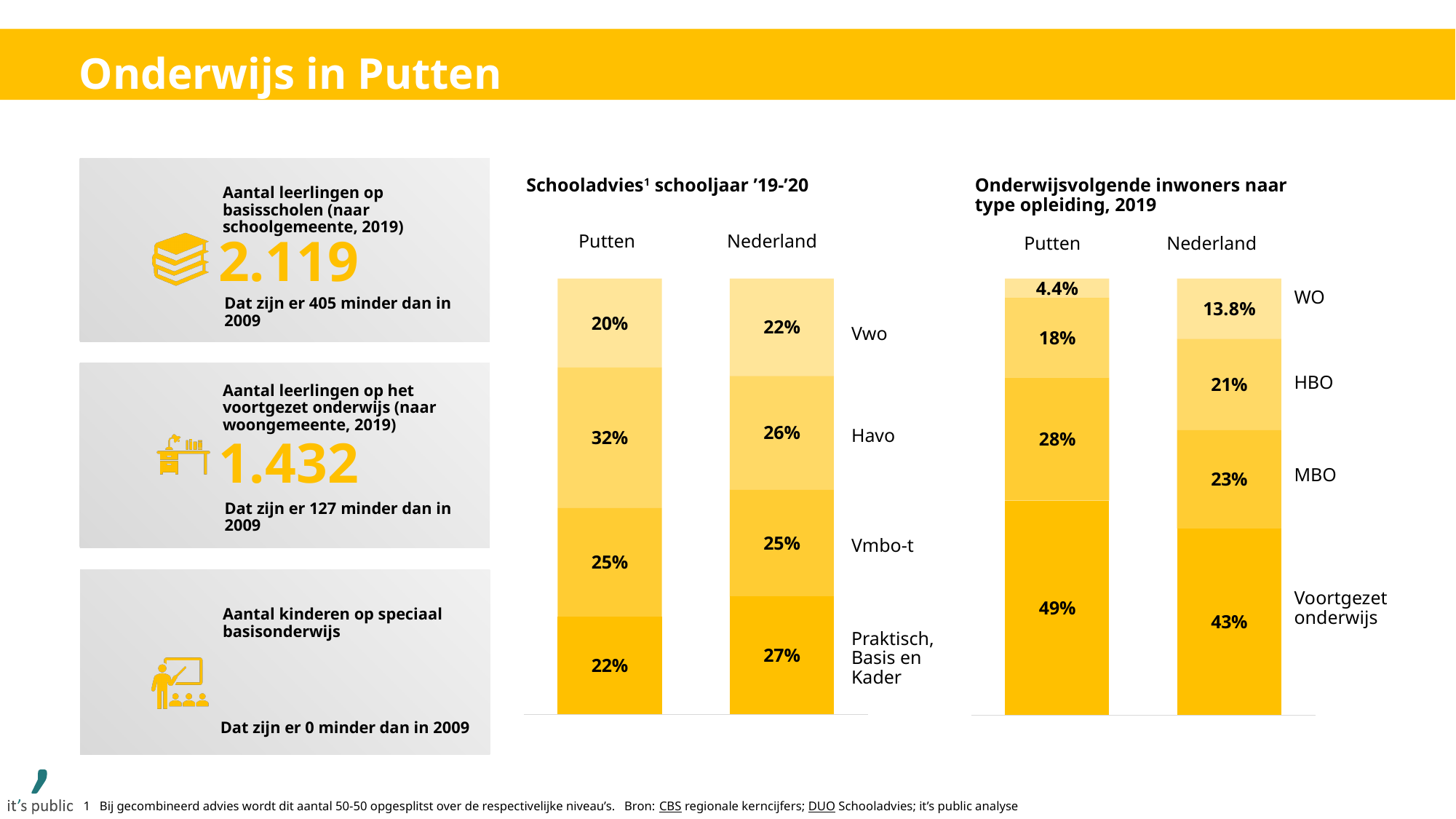
In the 'Onderwijsvolgende inwoners naar type opleiding, 2019' chart, what is the difference between the Voortgezet onderwijs share for Putten and for Nederland? 6 percentage points What kind of chart is 'Onderwijsvolgende inwoners naar type opleiding, 2019'? Stacked bar chart In the 'Onderwijsvolgende inwoners naar type opleiding, 2019' chart, what is the MBO share for Nederland? 23% In the 'Schooladvies schooljaar '19-'20' chart, which segment is the largest in the Putten bar? Havo In the 'Onderwijsvolgende inwoners naar type opleiding, 2019' chart, which segment is the smallest in the Nederland bar? WO In the 'Onderwijsvolgende inwoners naar type opleiding, 2019' chart, what is the WO share for Putten? 4.4% In the 'Schooladvies schooljaar '19-'20' chart, what is the difference between the Havo share for Putten and for Nederland? 6 percentage points In the 'Schooladvies schooljaar '19-'20' chart, which has a larger Vwo share, Putten or Nederland? Nederland In the 'Onderwijsvolgende inwoners naar type opleiding, 2019' chart, which has a larger HBO share, Putten or Nederland? Nederland In the 'Schooladvies schooljaar '19-'20' chart, what is the Praktisch, Basis en Kader share for Nederland? 27% In the 'Schooladvies schooljaar '19-'20' chart, what is the Havo share for Putten? 32% In the 'Schooladvies schooljaar '19-'20' chart, how many segments does each stacked bar have? 4